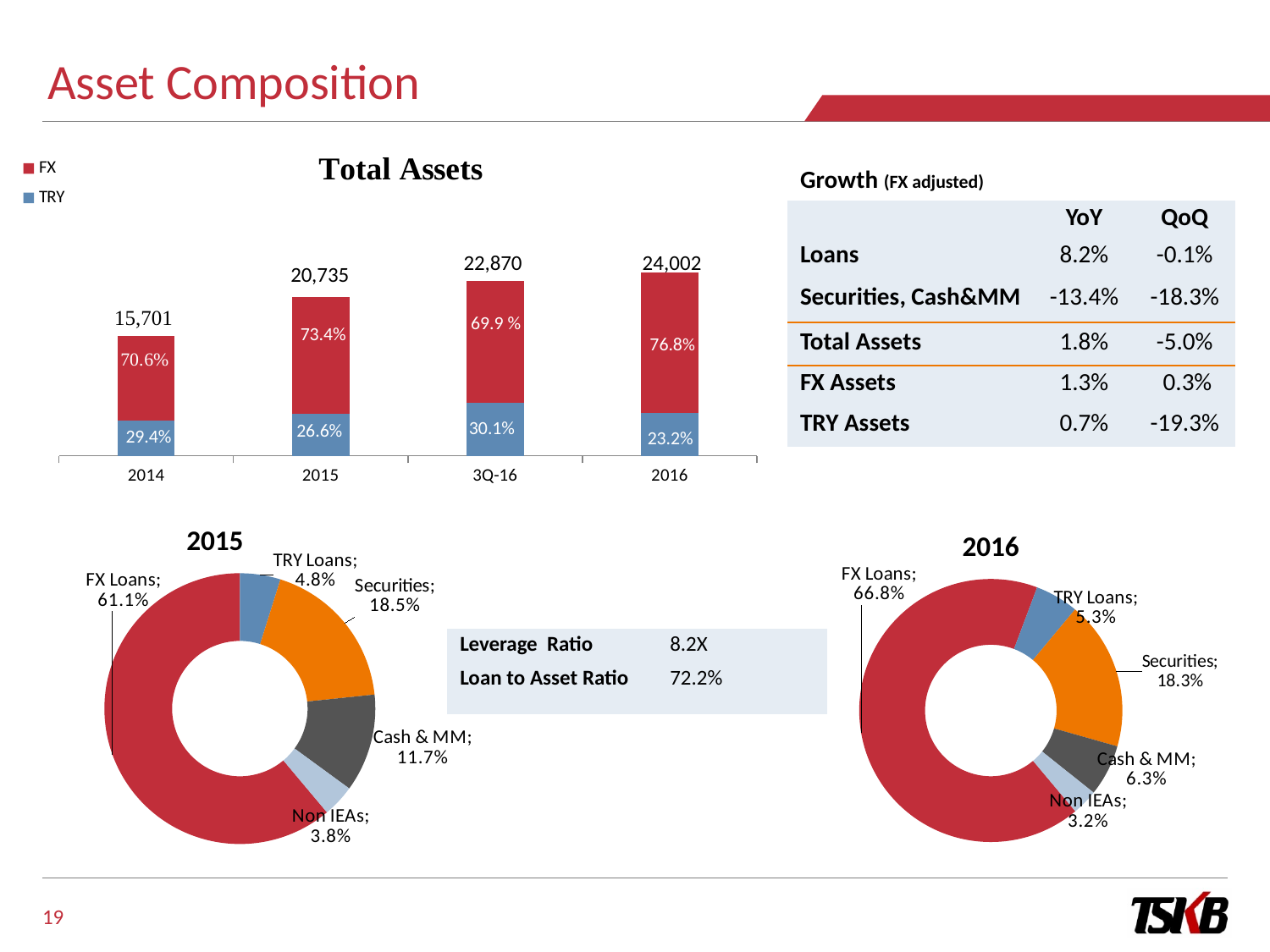
In the Total Assets chart, how many periods are shown on the x axis? 4 What kind of chart is the Total Assets chart? stacked bar chart In the Total Assets chart, what is the total assets value for 2015? 20,735 In the Total Assets chart, how many series does the legend list? 2 In the Total Assets chart, what is the difference between the total assets in 2016 and in 2014? 8,301 In the Total Assets chart, which period has the lowest total assets? 2014 In the 2015 pie chart, what share do Securities have? 18.5% In the Total Assets chart, what percentage of assets is FX in 2016? 76.8% In the Total Assets chart, do total assets rise or fall from 2014 to 2016? rise In the 2015 pie chart, which is larger, Securities or Cash & MM? Securities In the 2016 pie chart, which category has the largest share? FX Loans In the Total Assets chart, which period has the highest total assets? 2016